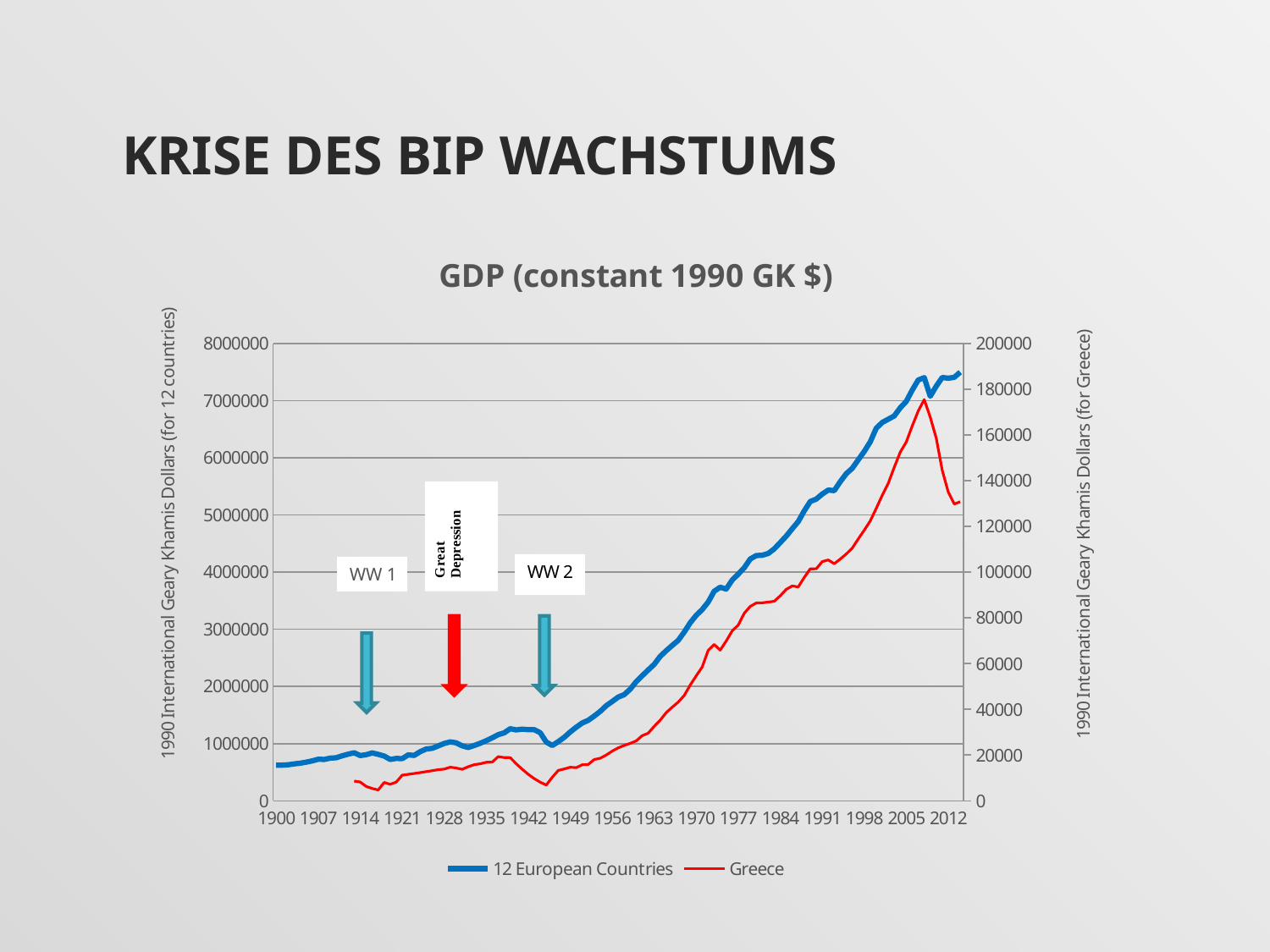
How many series does the legend list? 2 What is the title of the chart? GDP (constant 1990 GK $) How many year labels are shown on the x axis? 17 Is the value for 12 European Countries in 2012 greater or less than 7000000? greater Which series is drawn in red? Greece Does the value for 12 European Countries generally rise or fall from 1900 to 2005? rise Is the peak value for Greece greater or less than 160000? greater Is the value for Greece in 1963 greater or less than 40000? less What kind of chart is shown on the slide? line chart Does the value for Greece rise or fall between 2008 and 2012? fall